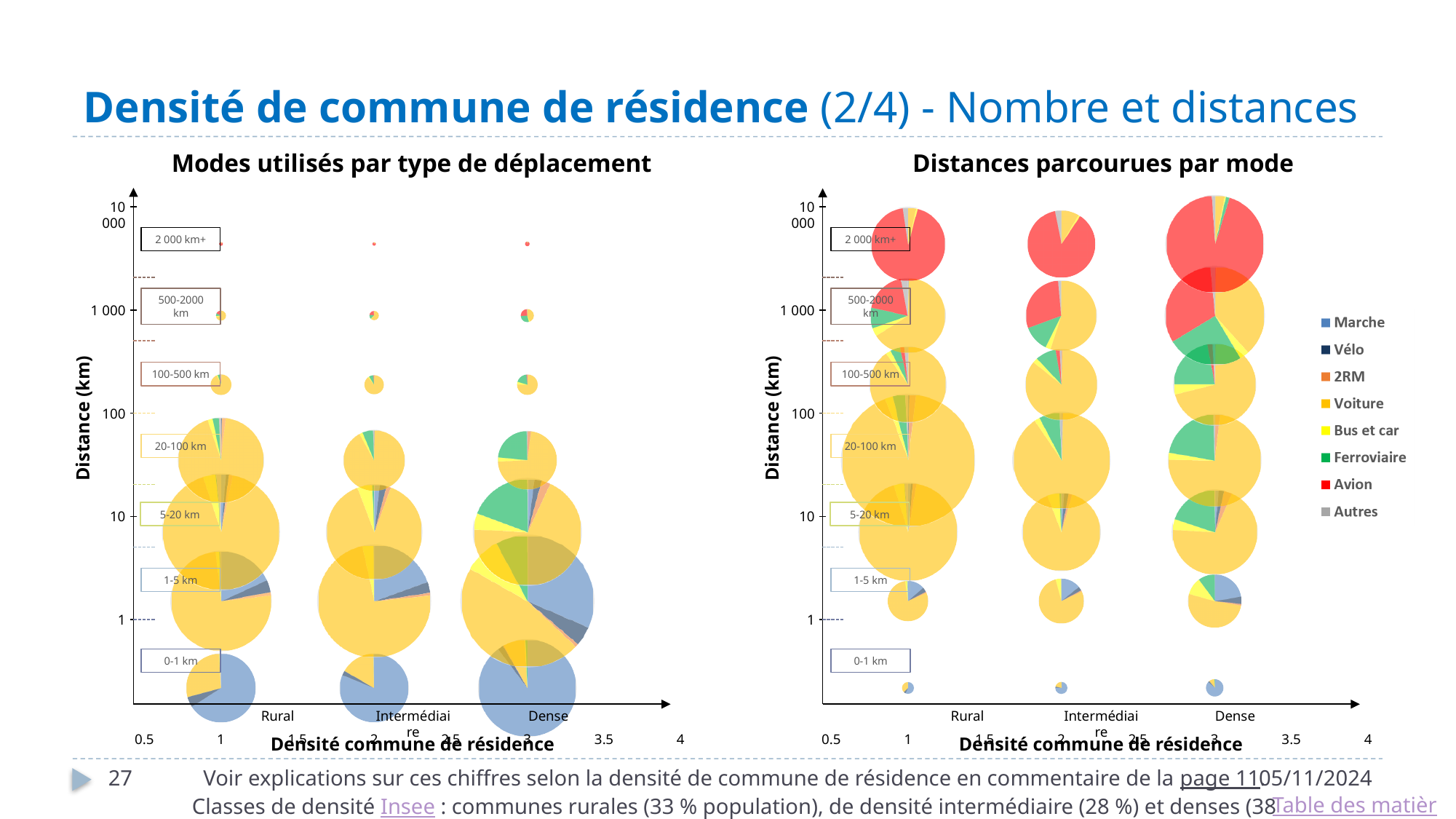
In the 'Distances parcourues par mode' chart, which mode dominates the 5-20 km bubbles? Voiture In the 'Distances parcourues par mode' chart, is the 2 000 km+ bubble larger for Dense or for Rural? Dense What is the y-axis label of the 'Modes utilisés par type de déplacement' chart? Distance (km) What kind of chart is 'Modes utilisés par type de déplacement'? Bubble chart (pie bubbles) How many distance classes are labelled along the y axis of the 'Modes utilisés par type de déplacement' chart? 7 How many density categories are shown along the x axis of the 'Distances parcourues par mode' chart? 3 In the 'Modes utilisés par type de déplacement' chart, which mode takes the largest share of the 0-1 km bubbles? Marche Which legend entry is shown in red? Avion In the 'Modes utilisés par type de déplacement' chart, is the 0-1 km bubble larger for Dense or for Rural? Dense How many series does the legend on the slide list? 8 In the 'Distances parcourues par mode' chart, which mode takes the largest share of the 2 000 km+ bubbles? Avion